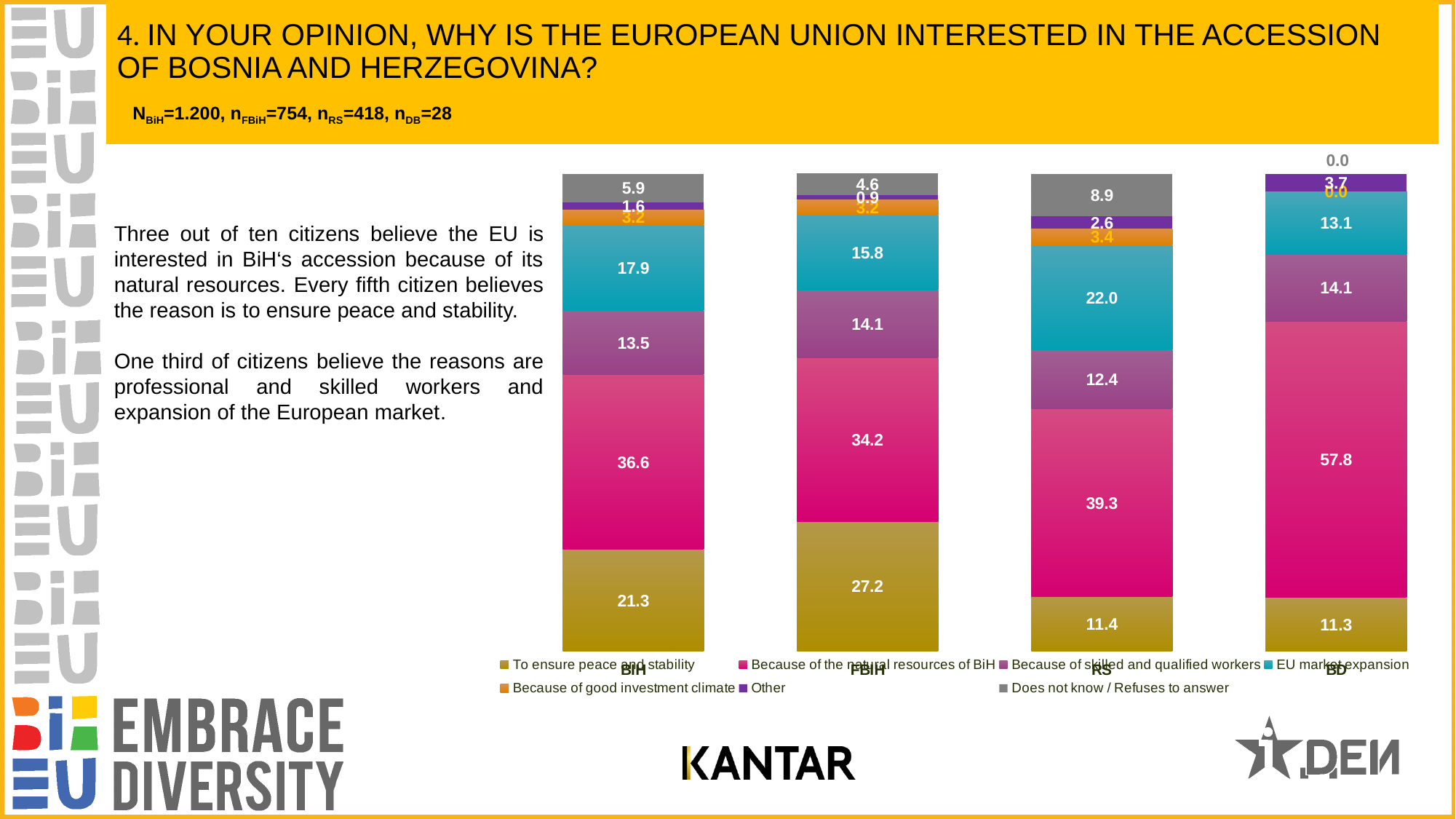
How many bars (categories) are shown on the x axis? 4 What is the value for 'To ensure peace and stability' in the FBiH bar? 27.2 What kind of chart is shown on the slide? stacked bar chart Which category has the lowest value for 'To ensure peace and stability'? BD Which is larger: the 'EU market expansion' value for BiH or for FBiH? BiH What is the value for 'Does not know / Refuses to answer' in the BiH bar? 5.9 Which legend entry is shown in the grey colour at the top of each bar? Does not know / Refuses to answer Which category has the highest value for 'Because of the natural resources of BiH'? BD What is the value for 'EU market expansion' in the RS bar? 22.0 What is the difference between the 'Because of the natural resources of BiH' values for BD and RS? 18.5 How many series does the legend list? 7 What is the value for 'Because of the natural resources of BiH' in the BD bar? 57.8